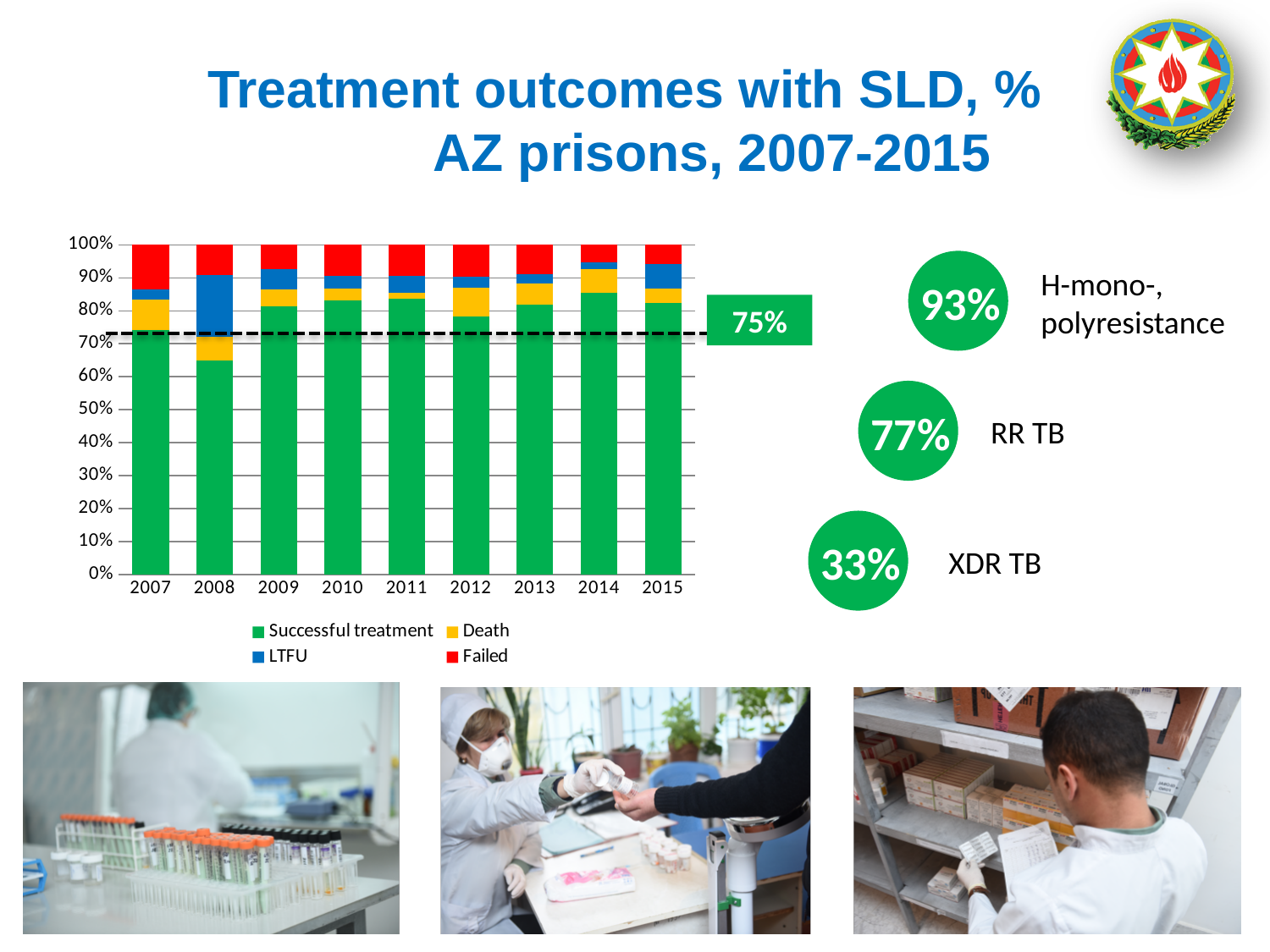
Which year has the lowest share of successful treatment? 2008 What value is marked by the dashed horizontal line on the chart? 75% Which colour represents Successful treatment in the chart legend? Green How many years are shown on the x axis of the chart? 9 Which year has the larger successful treatment share, 2008 or 2009? 2009 What is the total of the stacked bar for 2010? 100% Is the successful treatment share for 2014 greater or less than 80%? greater Which year has the larger LTFU share, 2007 or 2008? 2008 How many series does the chart legend list? 4 Is the successful treatment share for 2008 greater or less than 70%? less What kind of chart is shown on the slide? Stacked bar chart Is the successful treatment share for 2012 greater or less than 70%? greater